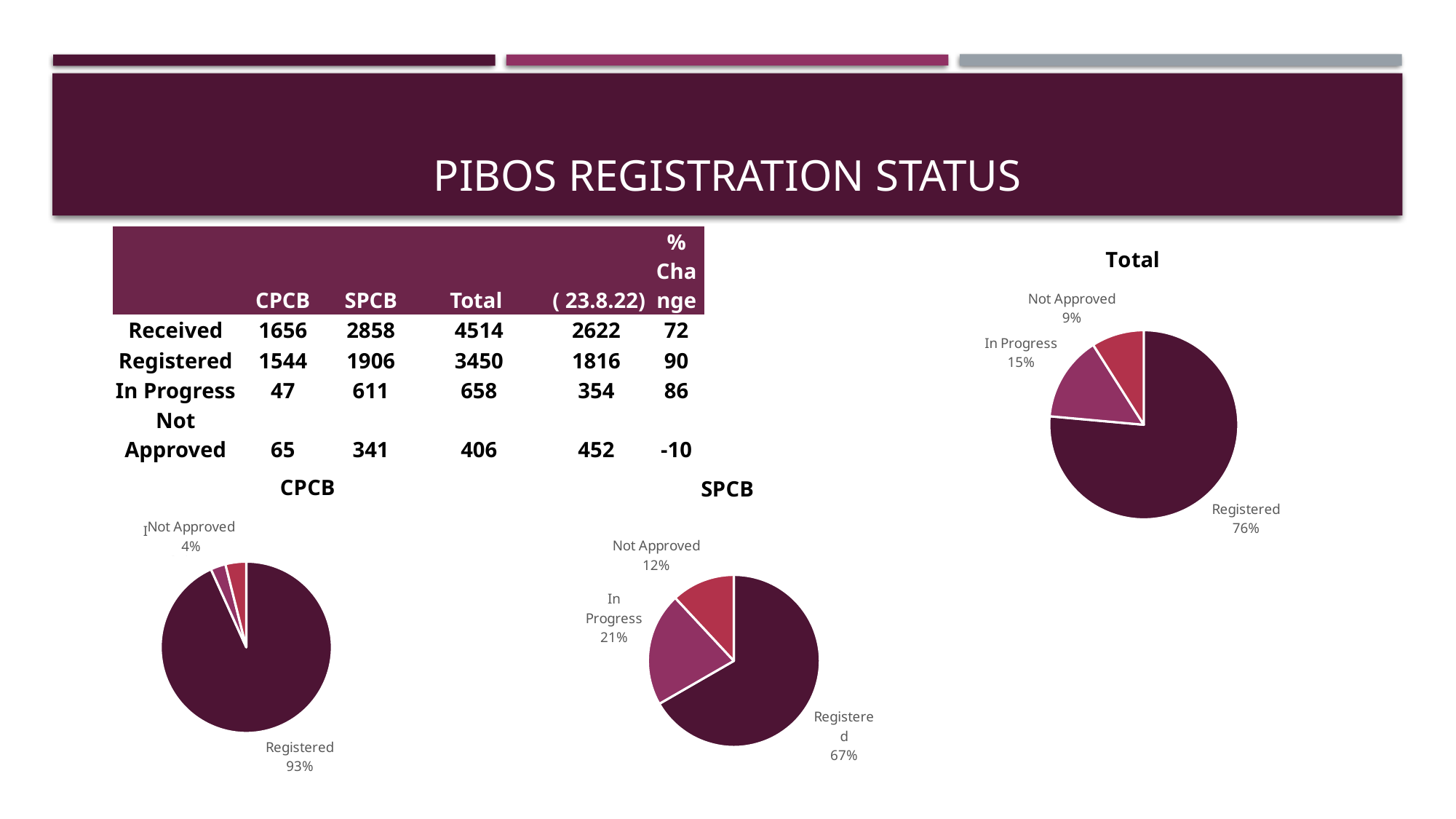
In the "CPCB" pie chart, what share does Not Approved have? 4% In the "SPCB" pie chart, what share does In Progress have? 21% In the "Total" pie chart, what share does Registered have? 76% What kind of chart is the "SPCB" chart? Pie chart In the "Total" pie chart, what share does In Progress have? 15% In the "Total" pie chart, which is larger, In Progress or Not Approved? In Progress In the "Total" pie chart, which category has the smallest slice? Not Approved In the "SPCB" pie chart, which category has the largest slice? Registered In the "SPCB" pie chart, what share does Not Approved have? 12% In the "CPCB" pie chart, what share does Registered have? 93% In the "SPCB" pie chart, what is the difference in percentage points between Registered and In Progress? 46 In the "Total" pie chart, what share does Not Approved have? 9%